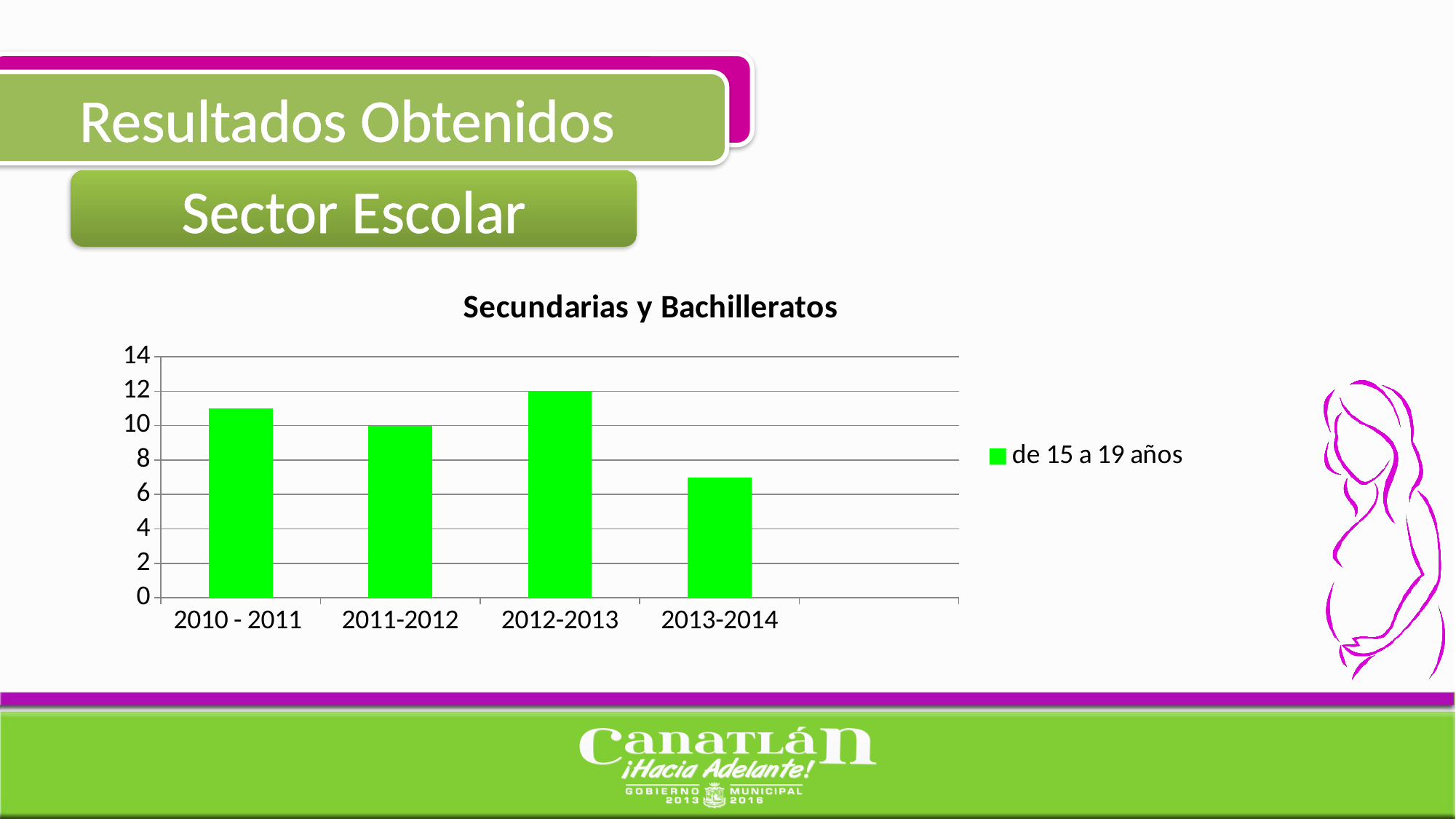
Is the value for 2010 - 2011 greater or less than 10? greater What type of chart is shown on the slide? bar chart What is the value for 2011-2012? 10 Is the value for 2013-2014 greater or less than 8? less Which category has the highest value? 2012-2013 What series does the chart's legend list? de 15 a 19 años Which category has the lowest value? 2013-2014 What is the title of the chart? Secundarias y Bachilleratos How many series does the legend list? 1 What is the difference between the values for 2012-2013 and 2011-2012? 2 What is the value for 2012-2013? 12 How many categories are shown on the x axis? 4